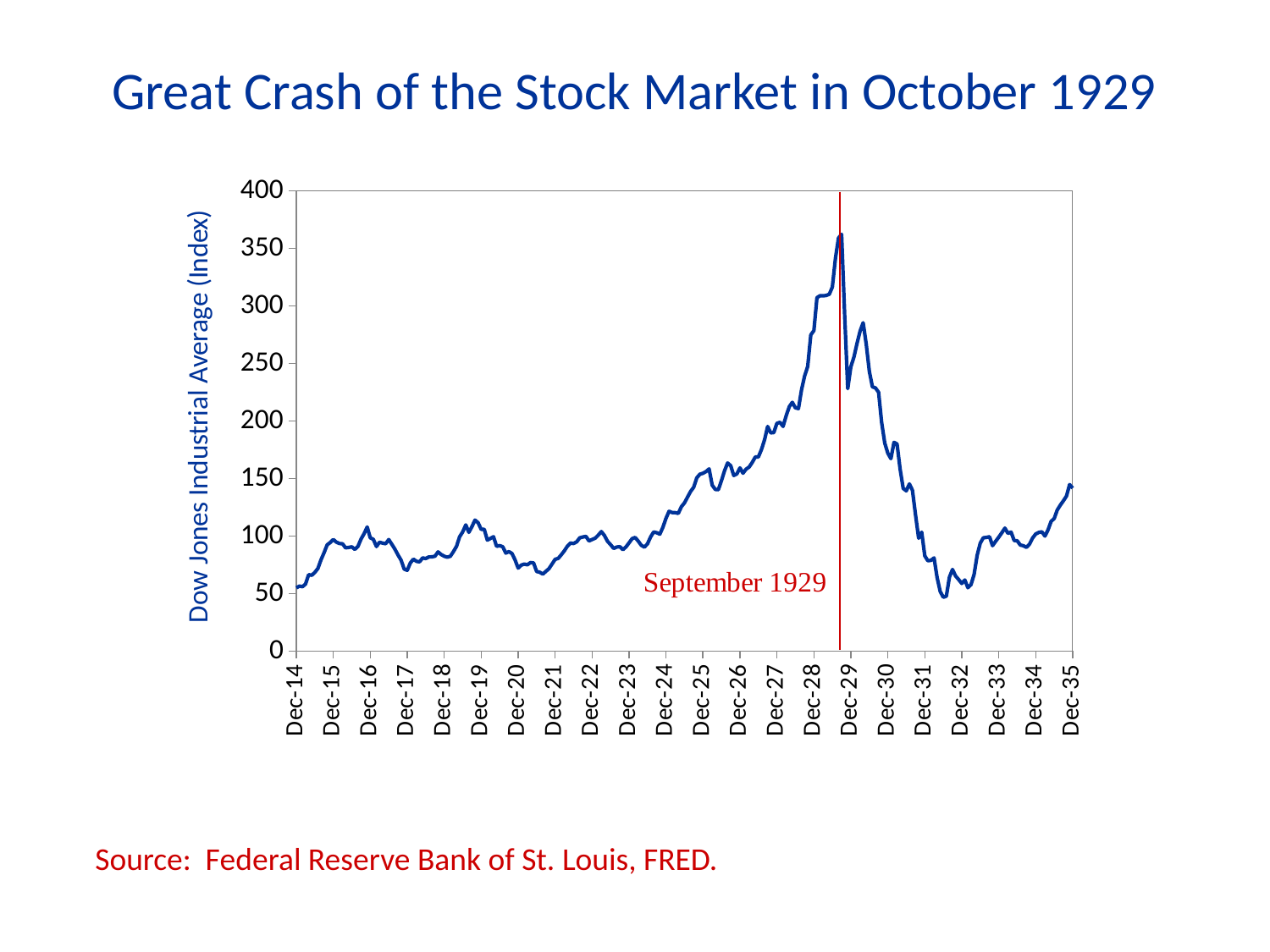
What kind of chart is shown on the slide? line chart Is the value for Dec-32 greater or less than 100? less Does the Dow Jones Industrial Average rise or fall between Dec-24 and September 1929? rise What is the label on the vertical axis of the chart? Dow Jones Industrial Average (Index) What is the title of the slide's chart? Great Crash of the Stock Market in October 1929 Is the value for Dec-14 greater or less than 100? less Is the peak value of the Dow Jones Industrial Average in 1929 greater or less than 350? greater How many date labels are shown on the horizontal axis of the chart? 22 In which year does the Dow Jones Industrial Average reach its lowest point on the chart? 1932 In which year does the Dow Jones Industrial Average reach its highest point on the chart? 1929 Does the Dow Jones Industrial Average rise or fall between September 1929 and Dec-31? fall